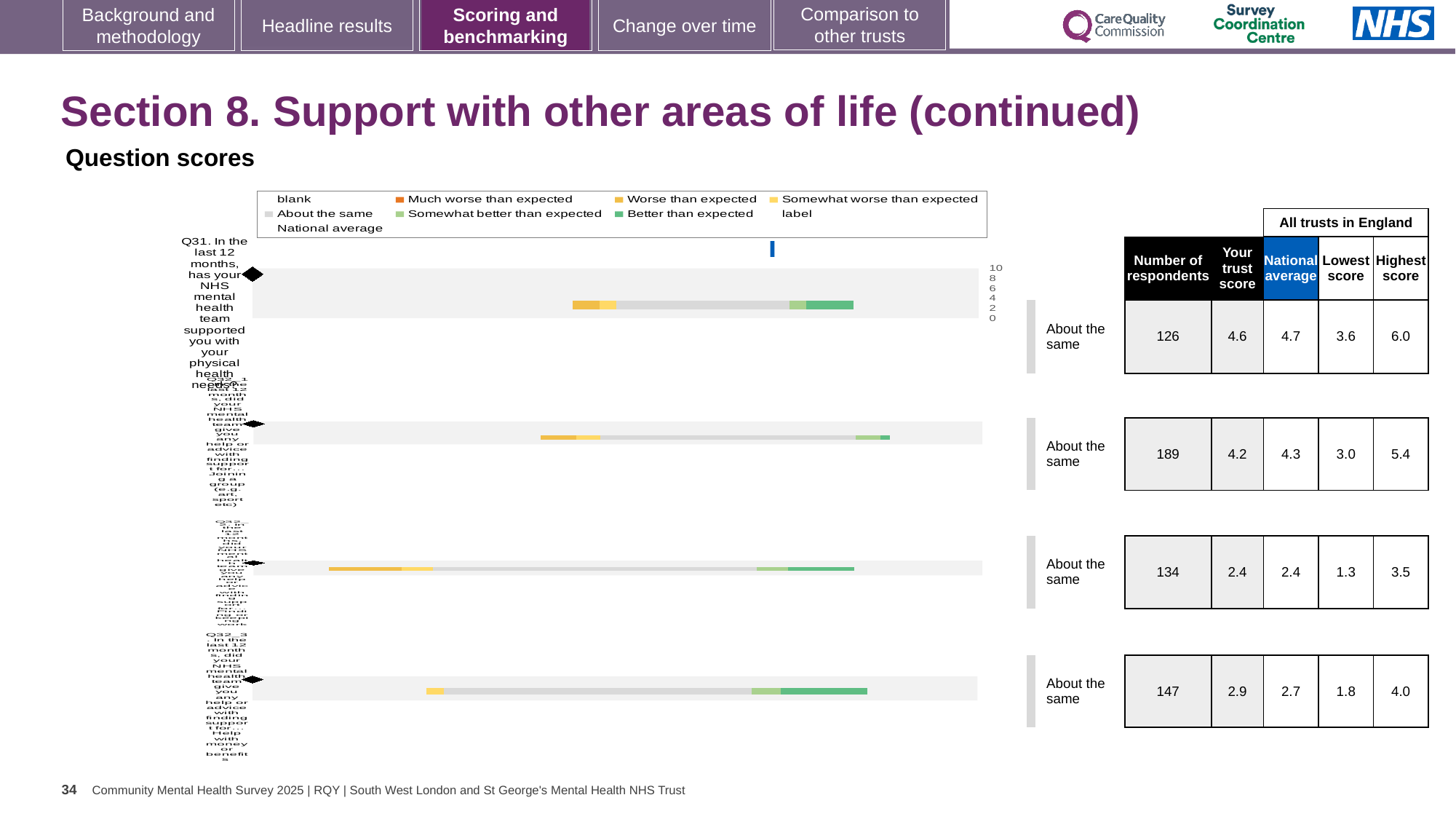
What kind of chart is shown on the slide? bar chart How many entries does the chart legend list? 9 What is the highest tick value shown on the chart's axis? 10 Which legend entry is shown in grey in the chart? About the same What is the national average for Q31, the first bar in the chart? 4.7 Is the trust score for the second bar in the chart (4.2) larger or smaller than its national average (4.3)? smaller Which of the four questions in the chart has the highest 'Your trust score'? Q31 How many question bars are plotted in the chart? 4 What is the difference between the highest score (6.0) and the lowest score (3.6) for Q31, the first bar in the chart? 2.4 What is the 'Your trust score' for Q31 (support with physical health needs), the first bar in the chart? 4.6 What benchmark category is shown next to every bar in the chart? About the same How many respondents answered Q31, the first question in the chart? 126